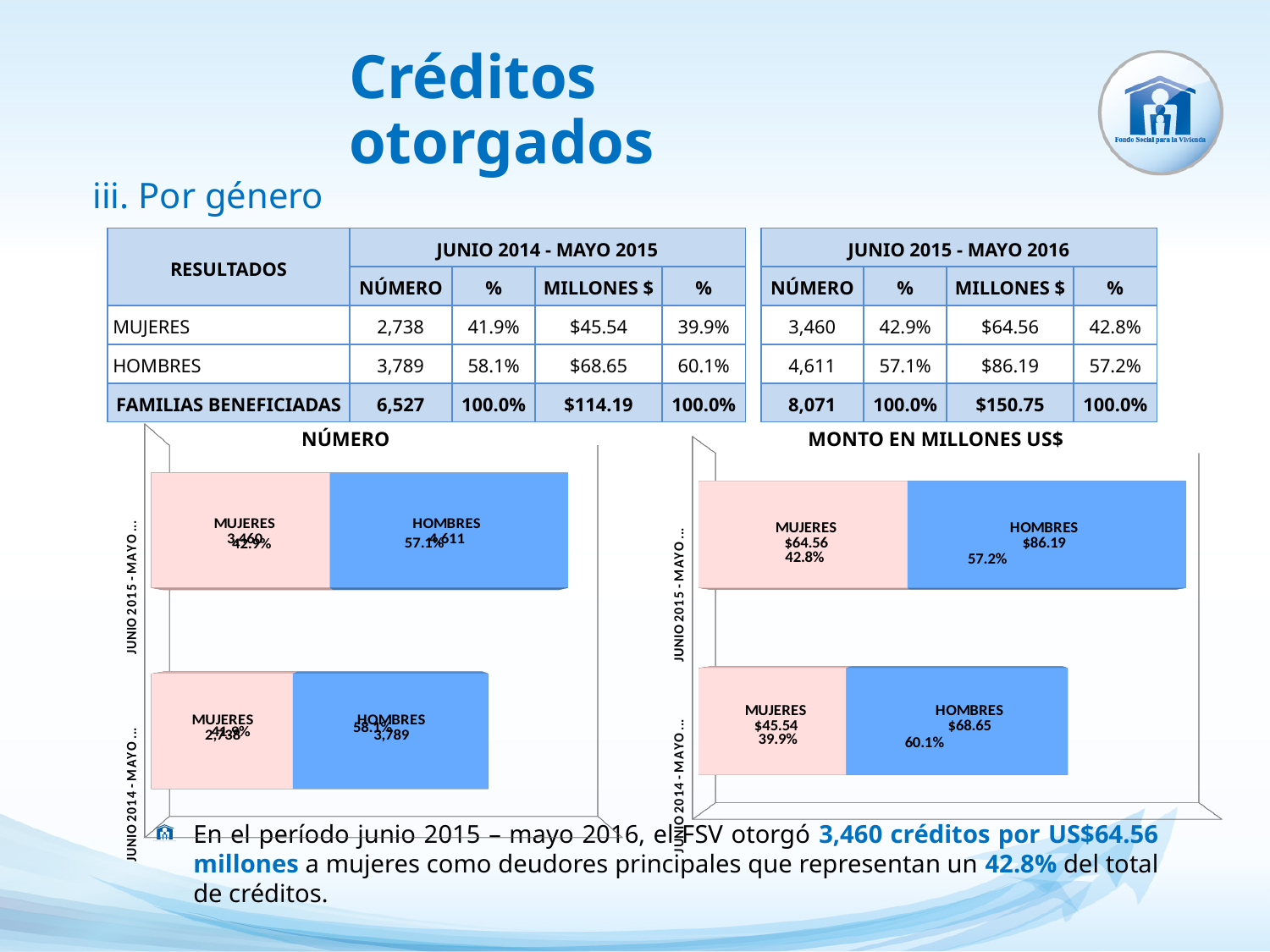
In the MONTO EN MILLONES US$ chart, what percentage is shown for HOMBRES in the JUNIO 2014 - MAYO bar? 60.1% How many bars (periods) does the MONTO EN MILLONES US$ chart show? 2 In the MONTO EN MILLONES US$ chart, what is the total of the JUNIO 2014 - MAYO stacked bar? $114.19 In the MONTO EN MILLONES US$ chart, what is the value for HOMBRES in the JUNIO 2015 - MAYO bar? $86.19 What kind of chart is the NÚMERO chart? Stacked bar chart In the MONTO EN MILLONES US$ chart, what is the difference between HOMBRES and MUJERES in the JUNIO 2015 - MAYO bar? $21.63 In the NÚMERO chart, which segment is larger in the JUNIO 2014 - MAYO bar, MUJERES or HOMBRES? HOMBRES In the MONTO EN MILLONES US$ chart, what percentage is shown for MUJERES in the JUNIO 2015 - MAYO bar? 42.8% In the NÚMERO chart, what is the value for MUJERES in the JUNIO 2014 - MAYO bar? 2,738 In the MONTO EN MILLONES US$ chart, what is the value for MUJERES in the JUNIO 2014 - MAYO bar? $45.54 In the MONTO EN MILLONES US$ chart, which segment is larger in the JUNIO 2015 - MAYO bar, MUJERES or HOMBRES? HOMBRES In the NÚMERO chart, what is the value for HOMBRES in the JUNIO 2015 - MAYO bar? 4,611